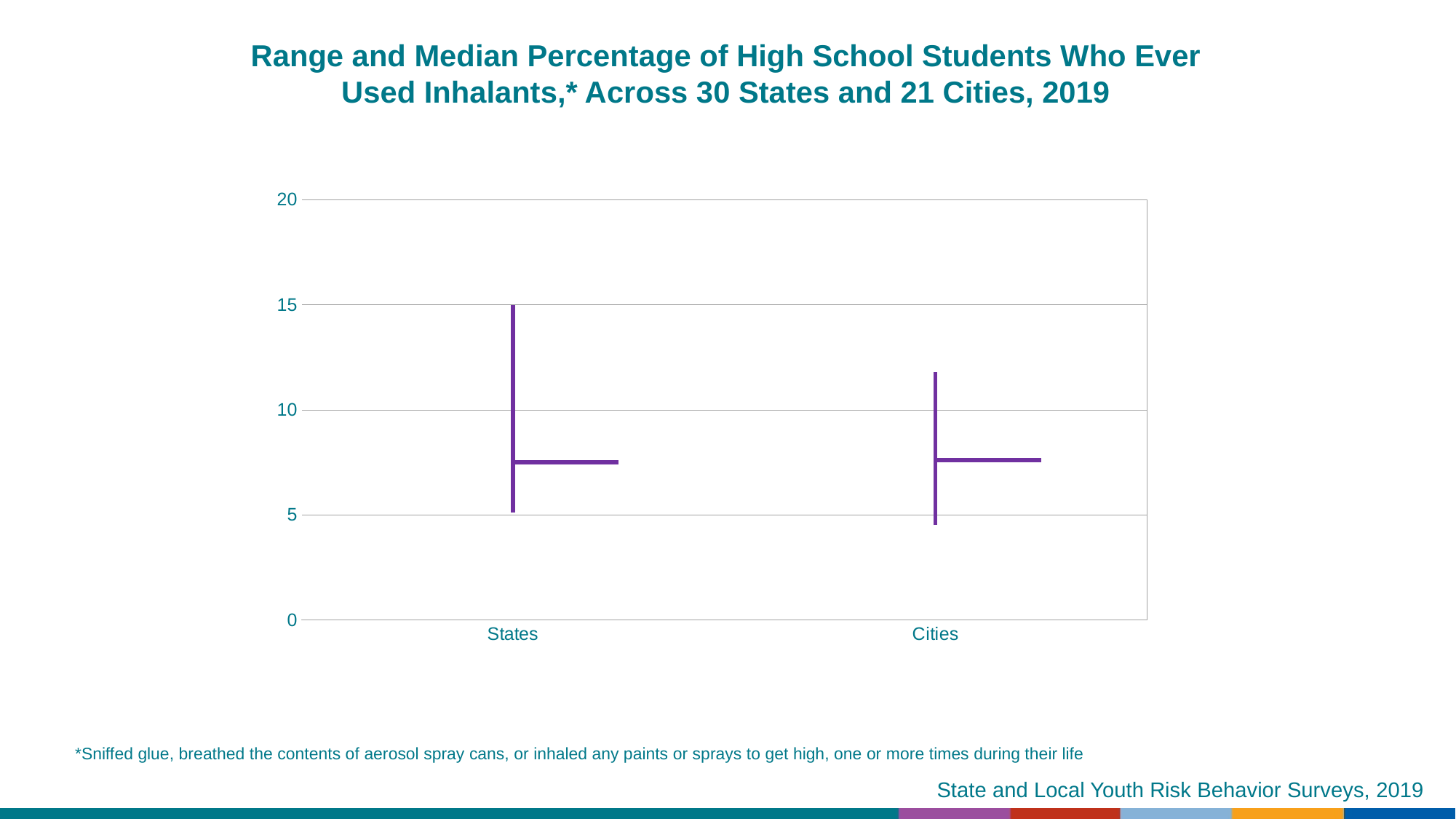
Is the median for Cities greater or less than 5? greater Is the top of the range for States greater or less than 10? greater What kind of chart is shown on the slide? A high-low range chart with median markers What are the two categories shown on the x axis? States and Cities Which category has the higher maximum value in its range, States or Cities? States How many categories are shown on the x axis of the chart? 2 Is the median for States greater or less than 10? less Which category has the wider range, States or Cities? States What is the highest value shown on the y axis? 20